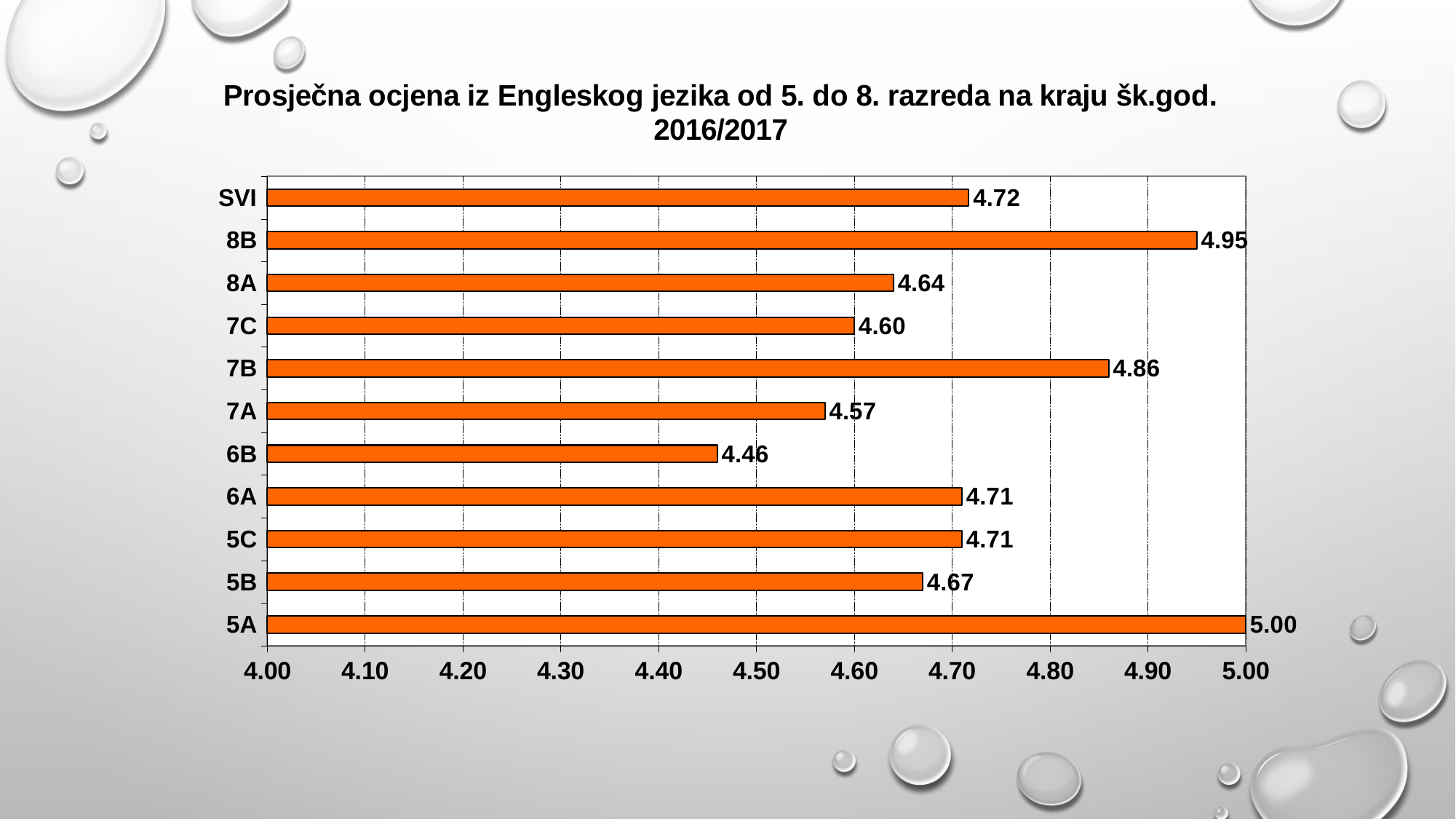
How many categories are shown on the chart? 11 Which class has the highest average grade? 5A What is the average grade for class 8B? 4.95 Which class has the lowest average grade? 6B What is the average grade for class 6B? 4.46 Which is larger, the value for 7C or the value for 5B? 5B What is the difference between the values for 7B and 7A? 0.29 What is the value shown for SVI? 4.72 Is the value for 7A greater or less than 4.60? less What is the difference between the values for 8B and 8A? 0.31 What kind of chart is shown on the slide? bar chart What colour are the bars in the chart? orange